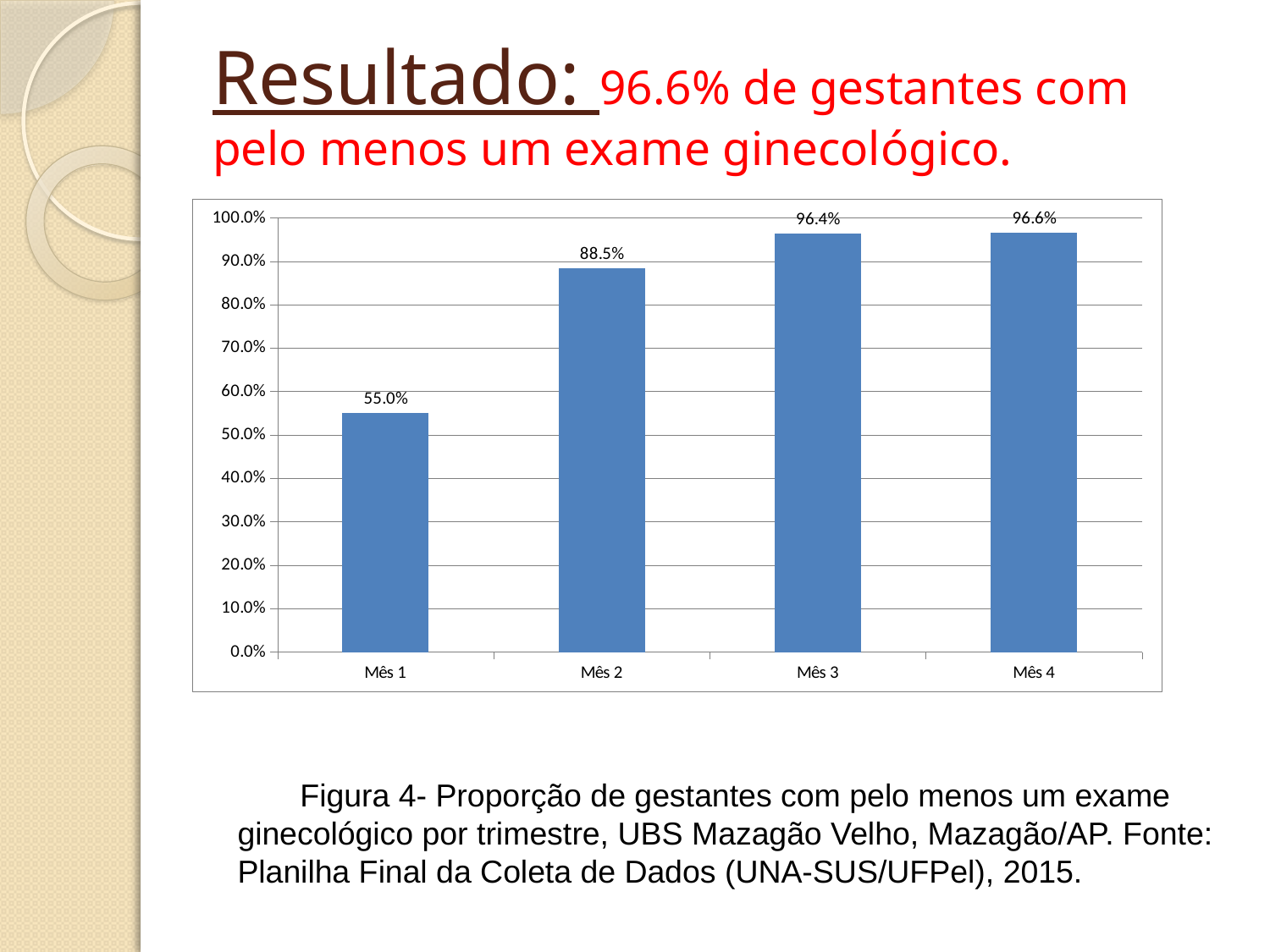
What kind of chart is shown on the slide? bar chart Which is larger, the value for Mês 2 or the value for Mês 3? Mês 3 How many months are shown on the x axis? 4 Is the value for Mês 1 greater or less than 60.0%? less Do the values rise or fall from Mês 1 to Mês 4? rise Which month has the highest value? Mês 4 Which month has the lowest value? Mês 1 What is the value for Mês 1? 55.0% What is the value for Mês 3? 96.4% What is the value for Mês 2? 88.5% What is the value for Mês 4? 96.6% What is the difference between the values for Mês 2 and Mês 1? 33.5%